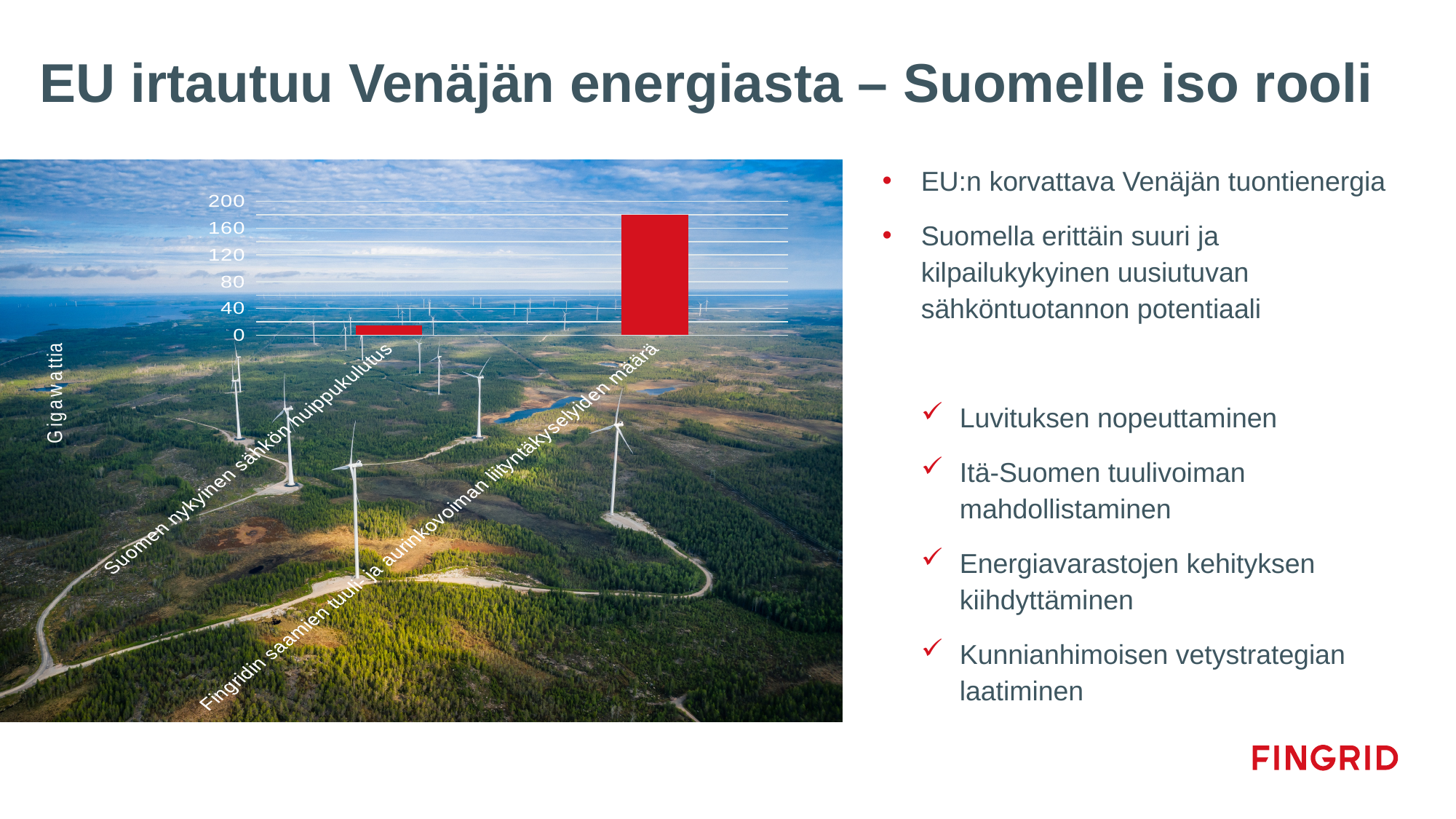
What kind of chart is shown on the slide? bar chart Which is larger: Suomen nykyinen sähkön huippukulutus or Fingridin saamien tuuli- ja aurinkovoiman liityntäkyselyiden määrä? Fingridin saamien tuuli- ja aurinkovoiman liityntäkyselyiden määrä Which category has the highest value in the chart? Fingridin saamien tuuli- ja aurinkovoiman liityntäkyselyiden määrä Is the value for Suomen nykyinen sähkön huippukulutus greater or less than 40? less What is the highest tick value shown on the vertical axis of the chart? 200 Which category has the lowest value in the chart? Suomen nykyinen sähkön huippukulutus Is the value for Fingridin saamien tuuli- ja aurinkovoiman liityntäkyselyiden määrä greater or less than 160? greater Is the value for Fingridin saamien tuuli- ja aurinkovoiman liityntäkyselyiden määrä greater or less than 200? less What is the label of the vertical axis of the chart? Gigawattia How many bars does the chart show? 2